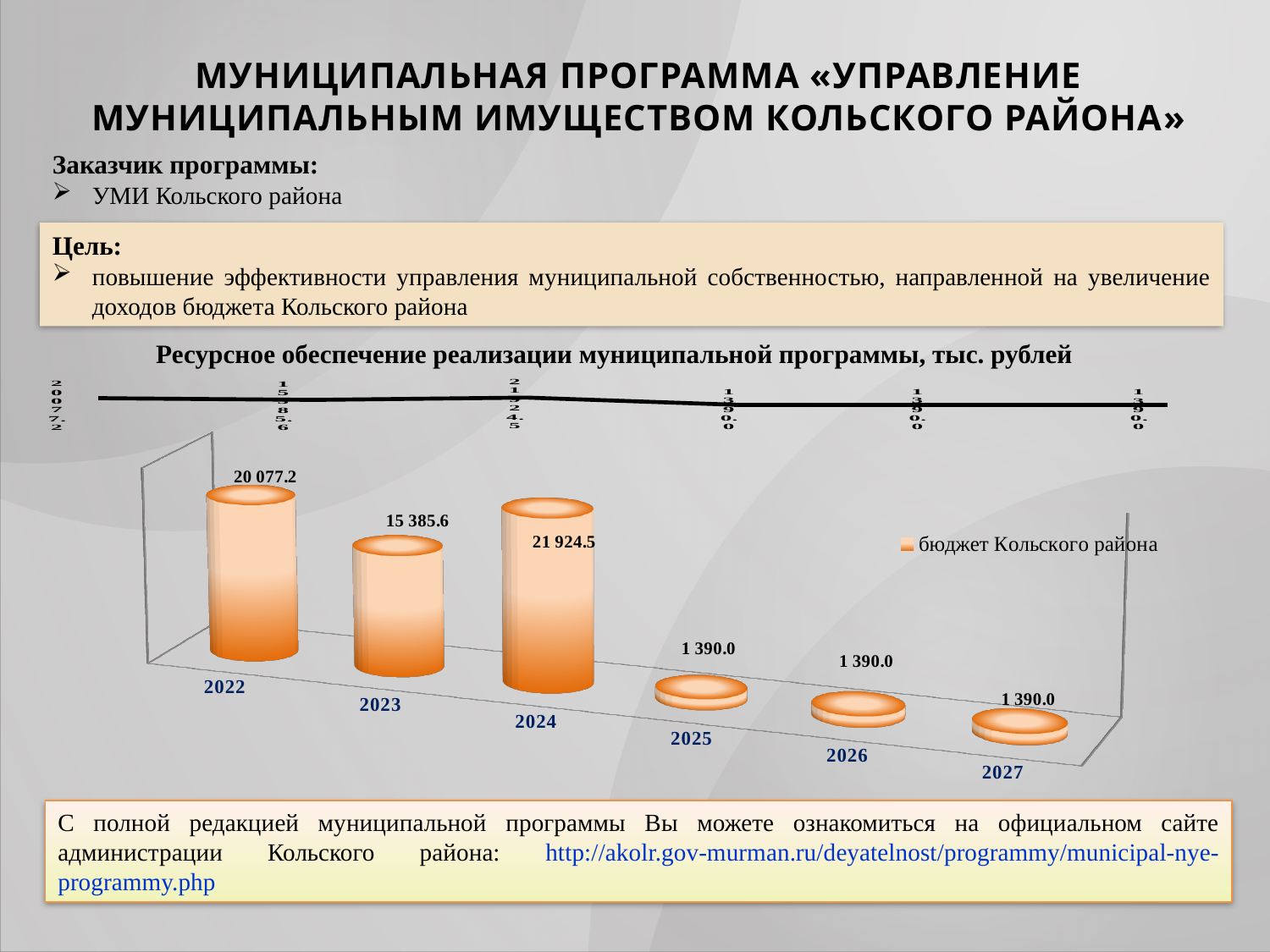
How many years are shown on the x axis of the chart? 6 What kind of chart is shown on the slide? A 3D bar chart and a line chart What is the value for 2022 in the chart? 20 077.2 What is the difference between the values for 2022 and 2023? 4 691.6 What is the value for 2023 in the chart? 15 385.6 What is the difference between the values for 2024 and 2022? 1 847.3 What series name is shown in the chart legend? бюджет Кольского района What is the title of the chart? Ресурсное обеспечение реализации муниципальной программы, тыс. рублей Which is larger, the value for 2023 or the value for 2025? 2023 Which year has the highest value in the chart? 2024 What is the value for 2026 in the chart? 1 390.0 What is the value for 2024 in the chart? 21 924.5